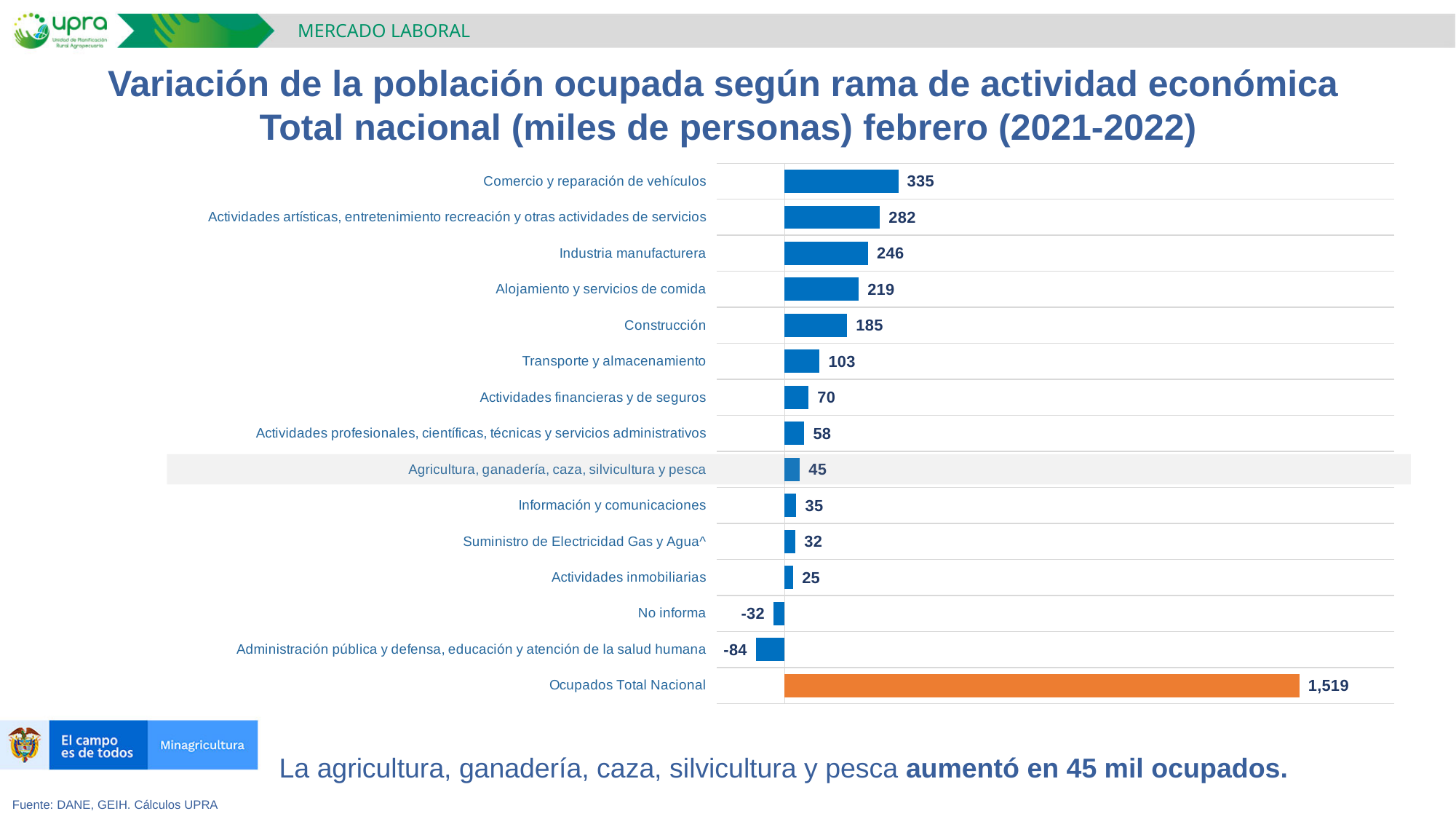
Which bar is coloured orange? Ocupados Total Nacional What kind of chart is shown on the slide? Bar chart What is the difference between the values for Comercio y reparación de vehículos and Industria manufacturera? 89 What is the value for Ocupados Total Nacional? 1,519 What is the value for Comercio y reparación de vehículos? 335 What is the value for Agricultura, ganadería, caza, silvicultura y pesca? 45 Excluding Ocupados Total Nacional, which category has the highest value? Comercio y reparación de vehículos How many categories have a negative value? 2 Which is larger, the value for Construcción or the value for Transporte y almacenamiento? Construcción How many categories are shown in the chart? 15 What is the value for Administración pública y defensa, educación y atención de la salud humana? -84 Which category has the lowest value? Administración pública y defensa, educación y atención de la salud humana